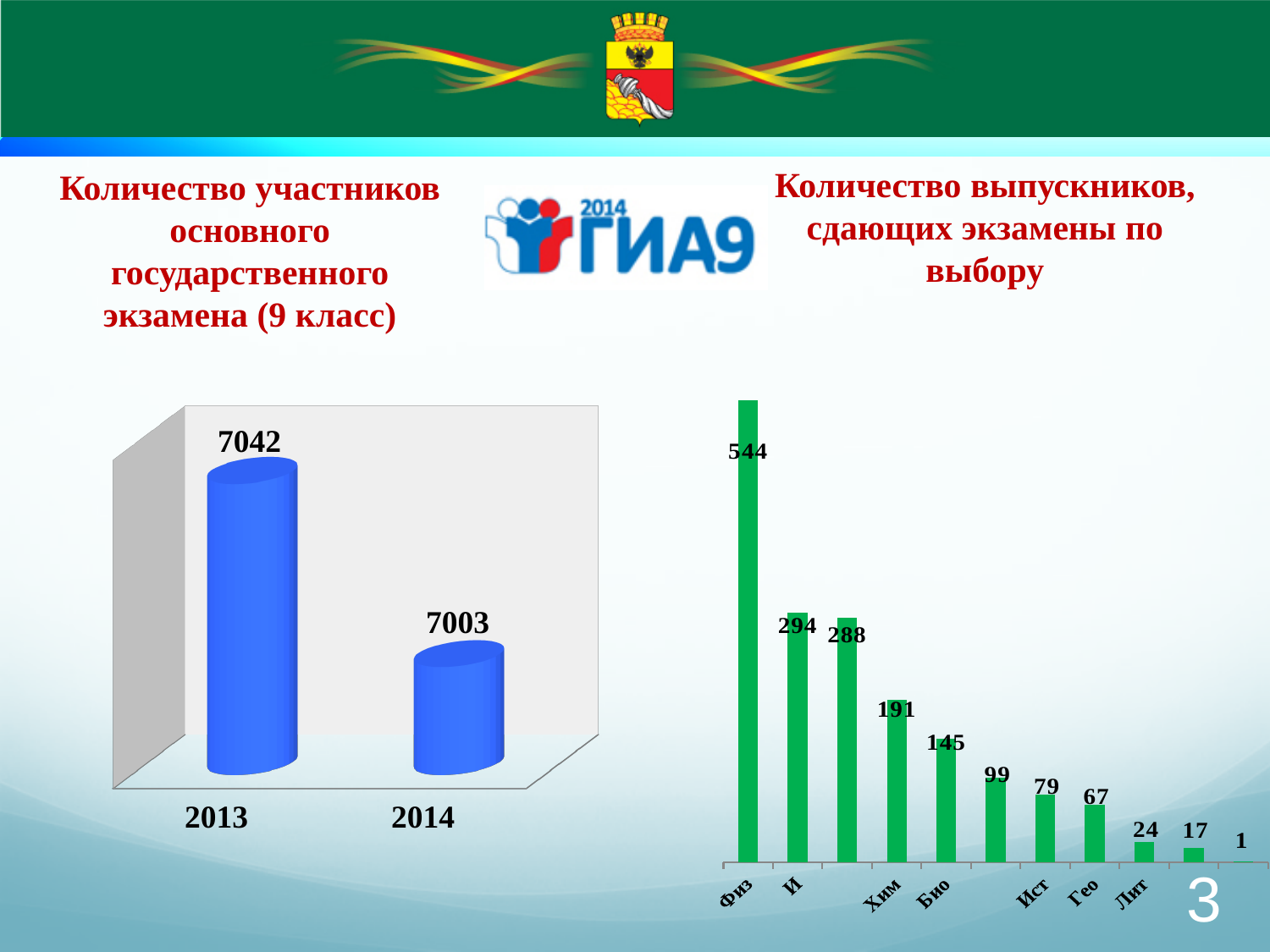
On the left chart (Количество участников основного государственного экзамена), what is the value for 2014? 7003 On the right chart (Количество выпускников, сдающих экзамены по выбору), what is the value for Хим? 191 On the left chart, what is the difference between the 2013 and 2014 values? 39 On the right chart, how many bars are plotted? 11 On the right chart, what is the difference between the values for Хим and Био? 46 On the right chart, what is the value for Био? 145 On the right chart (Количество выпускников, сдающих экзамены по выбору), which category has the highest value? Физ On the left chart, do the values rise or fall from 2013 to 2014? fall On the left chart (Количество участников основного государственного экзамена), what is the value for 2013? 7042 On the left chart, which year has the larger value, 2013 or 2014? 2013 What kind of chart is the left chart? bar chart On the right chart, what is the value for Лит? 24